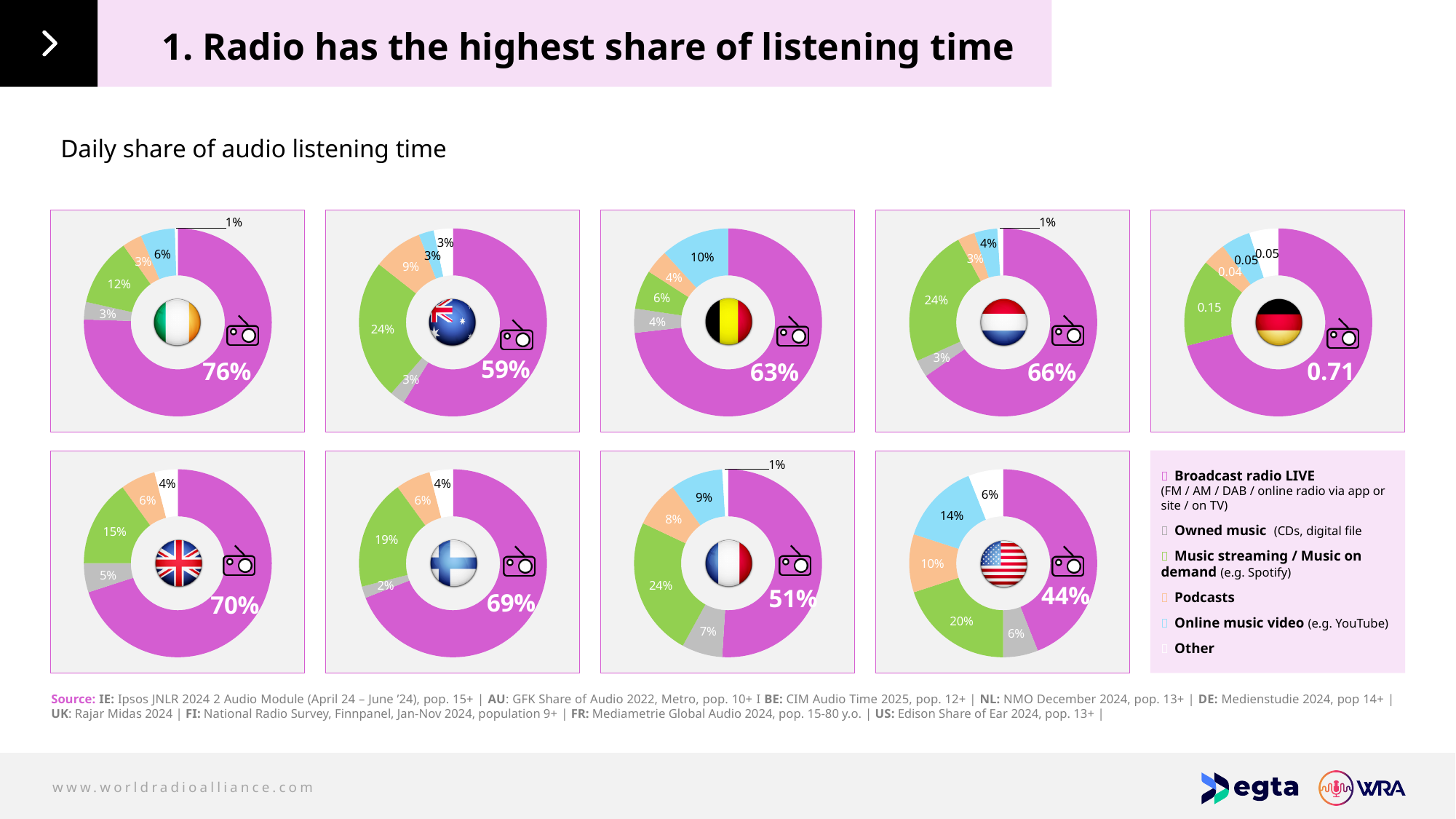
Across the nine country charts, which country shows the highest share for the magenta radio segment? Ireland (76%) In the Germany chart (top right), what value is printed on the large magenta segment? 0.71 How many categories does the legend on the right list? 6 What is the difference between the radio share in the Ireland chart (76%) and the radio share in the US chart (44%)? 32% In the France chart (bottom row, third), what is the value of the magenta radio segment? 51% In the Ireland chart (top left), what share of daily audio listening time is shown for the large magenta segment with the radio icon? 76% How many country charts are shown on the slide? 9 Across the nine country charts, which country shows the lowest share for the magenta radio segment? United States (44%) In the US chart (bottom row, fourth), what value is printed on the green segment? 20% In the Australia chart (top row, second), what value is printed on the green segment? 24% What kind of chart is used for each country on this slide? Pie (donut) chart Which has a larger magenta radio share: the Netherlands chart or the Belgium chart? Netherlands (66% vs 63%)